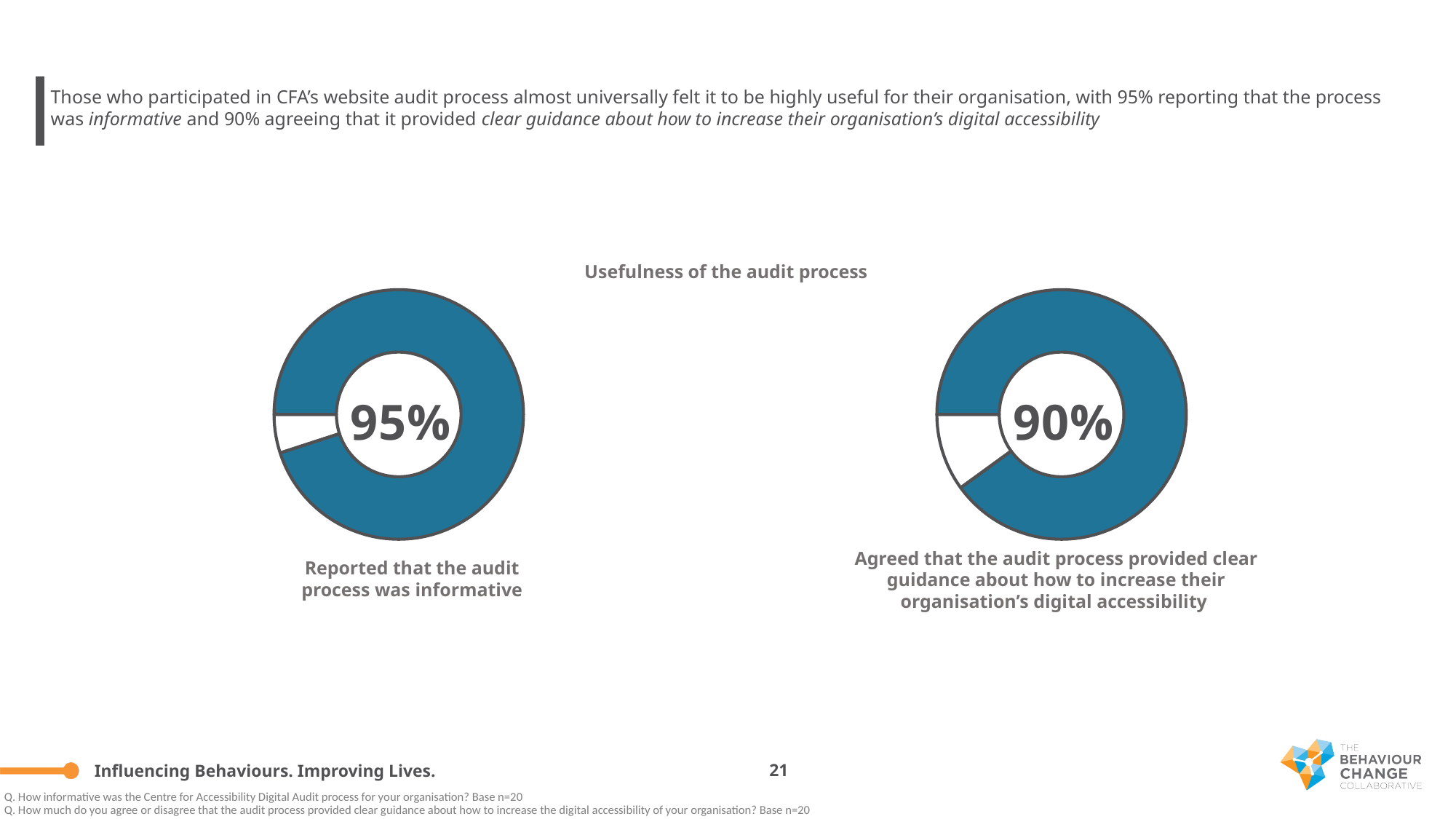
How many donut charts are shown on the slide? 2 What kind of chart is used to show the usefulness of the audit process? Donut (pie) chart In the right donut chart, what share of the donut is not filled in blue (i.e. did not agree that clear guidance was provided)? 10% What is the title shown above the donut charts? Usefulness of the audit process What colour is the filled portion of the donut charts? Blue In the left donut chart, is the value for 'reported that the audit process was informative' greater or less than 50%? greater In the right donut chart, what percentage agreed that the audit process provided clear guidance about how to increase their organisation's digital accessibility? 90% In the left donut chart, what percentage reported that the audit process was informative? 95% Which result is lower: the percentage who found the audit process informative or the percentage who agreed it provided clear guidance? Clear guidance (90%) Which of the two donut charts shows the higher percentage, the one for 'informative' or the one for 'clear guidance'? Informative (95%) What is the difference in percentage points between the 'informative' result (left chart) and the 'clear guidance' result (right chart)? 5 percentage points